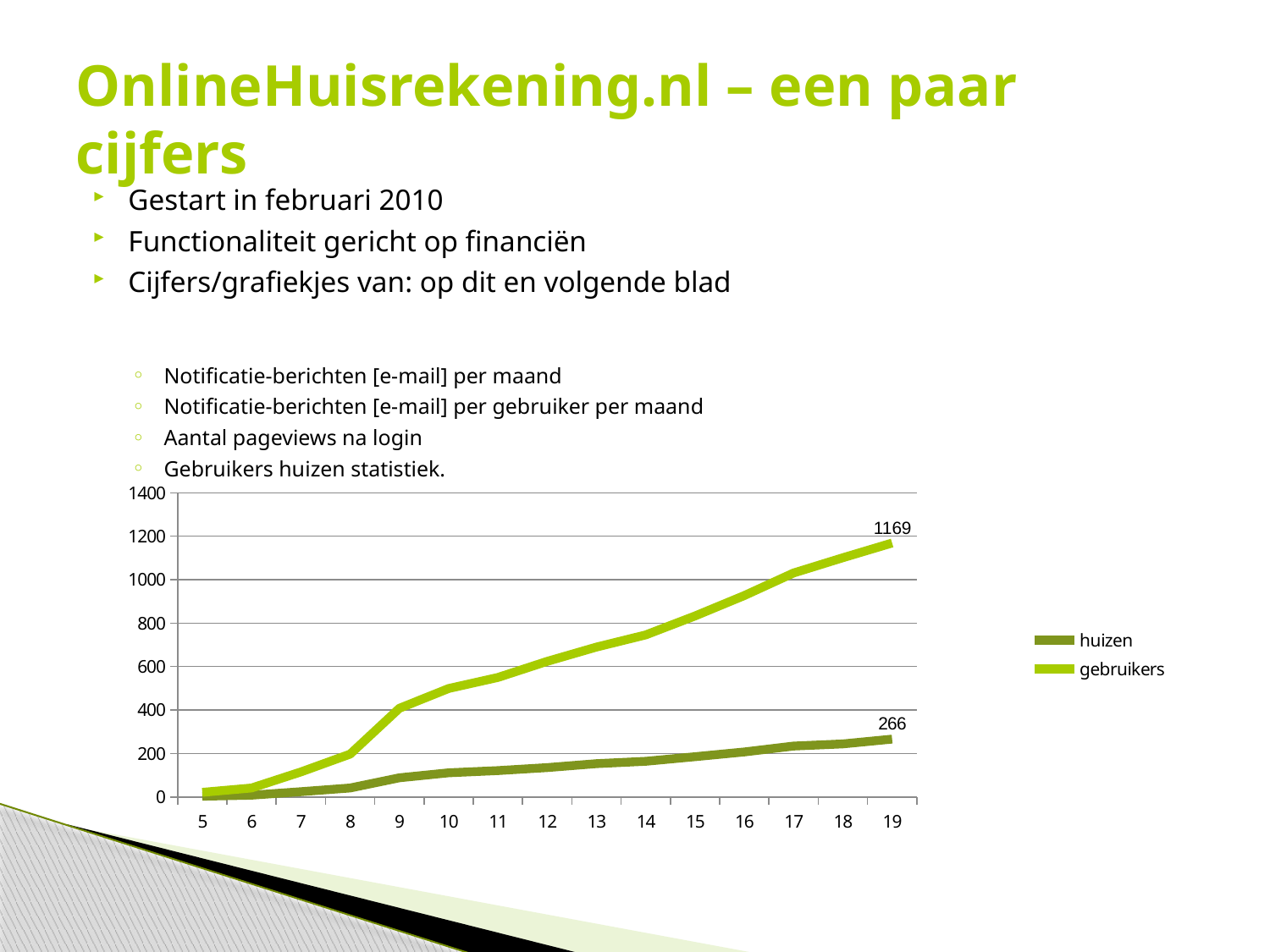
Is the value of the gebruikers series at x = 16 greater or less than 800? greater Which two series are listed in the chart legend? huizen and gebruikers At x = 19, which series has the larger value, huizen or gebruikers? gebruikers What is the value of the huizen series at x = 19? 266 What is the difference between the gebruikers value and the huizen value at x = 19? 903 What is the value of the gebruikers series at x = 19? 1169 How many series does the legend list? 2 Is the value of the huizen series at x = 14 greater or less than 200? less Does the gebruikers series rise or fall from x = 5 to x = 19? rise Is the value of the gebruikers series at x = 13 greater or less than 600? greater What kind of chart is shown on the slide? line chart How many points are shown on the x axis of the chart? 15